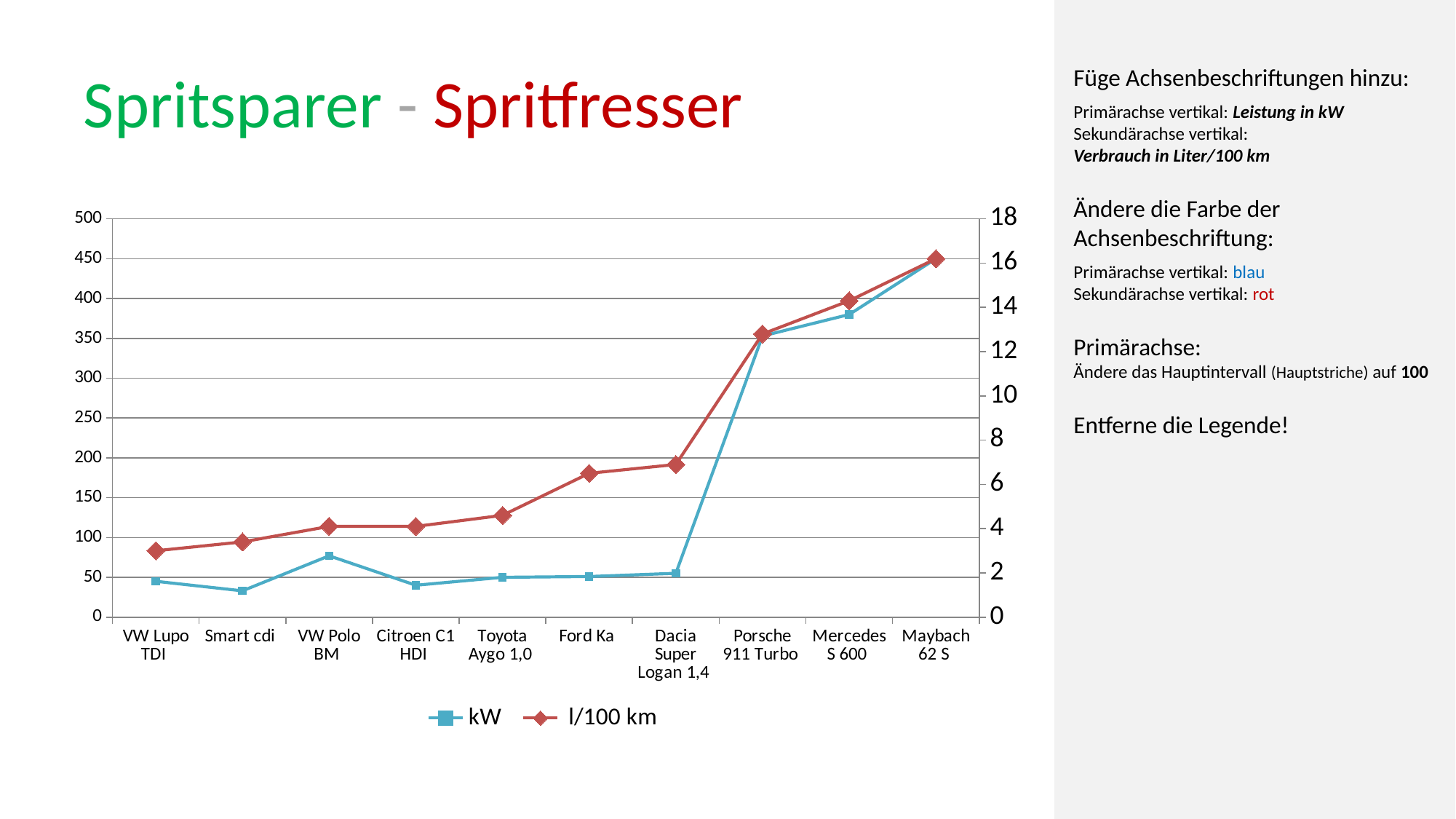
Is the kW value for VW Polo BM greater or less than 100? less Which car has the lowest l/100 km value? VW Lupo TDI Which car has the highest l/100 km value? Maybach 62 S Which car has the highest kW value? Maybach 62 S How many car models are plotted along the x axis? 10 Is the kW value for Porsche 911 Turbo greater or less than 300? greater Which has the higher kW value, Mercedes S 600 or Porsche 911 Turbo? Mercedes S 600 Is the l/100 km value for Ford Ka greater or less than 6? greater How many series does the legend list? 2 What kind of chart is shown on the slide? line chart Which car has the lowest kW value? Smart cdi Does the l/100 km series generally rise or fall from left to right along the x axis? rise